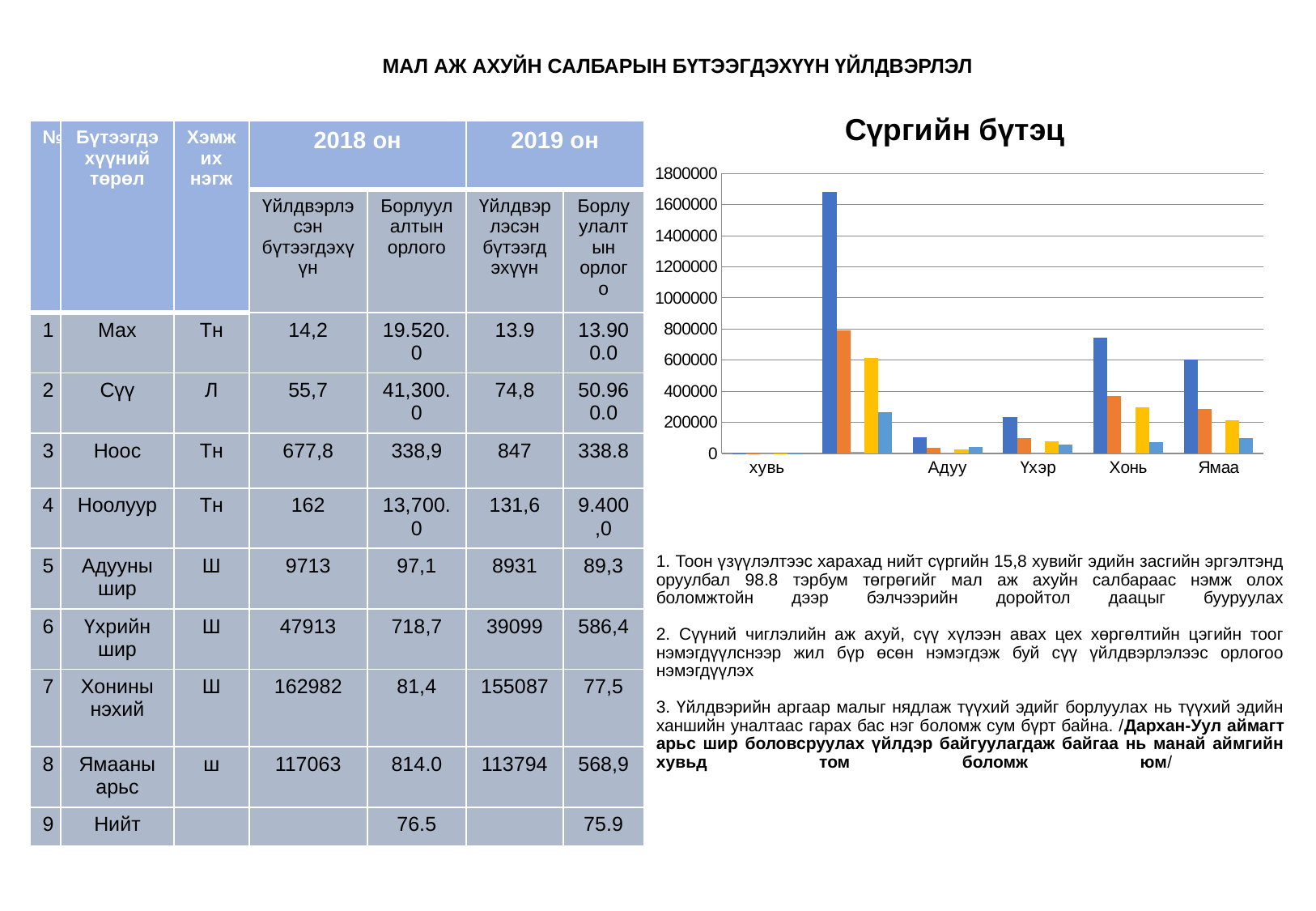
Is the tallest (blue) bar for Адуу greater or less than 200000? less What is the highest value shown on the chart's vertical axis? 1800000 What kind of chart is shown on the slide? bar chart Is the orange bar for Ямаа greater or less than 400000? less Among Адуу, Үхэр, Хонь and Ямаа, which category has the shortest blue bar? Адуу Is the tallest (blue) bar for Үхэр greater or less than 400000? less Which has the taller blue bar, Хонь or Ямаа? Хонь What is the title of the chart on the slide? Сүргийн бүтэц Among Адуу, Үхэр, Хонь and Ямаа, which category has the tallest blue bar? Хонь Which has the taller blue bar, Адуу or Үхэр? Үхэр